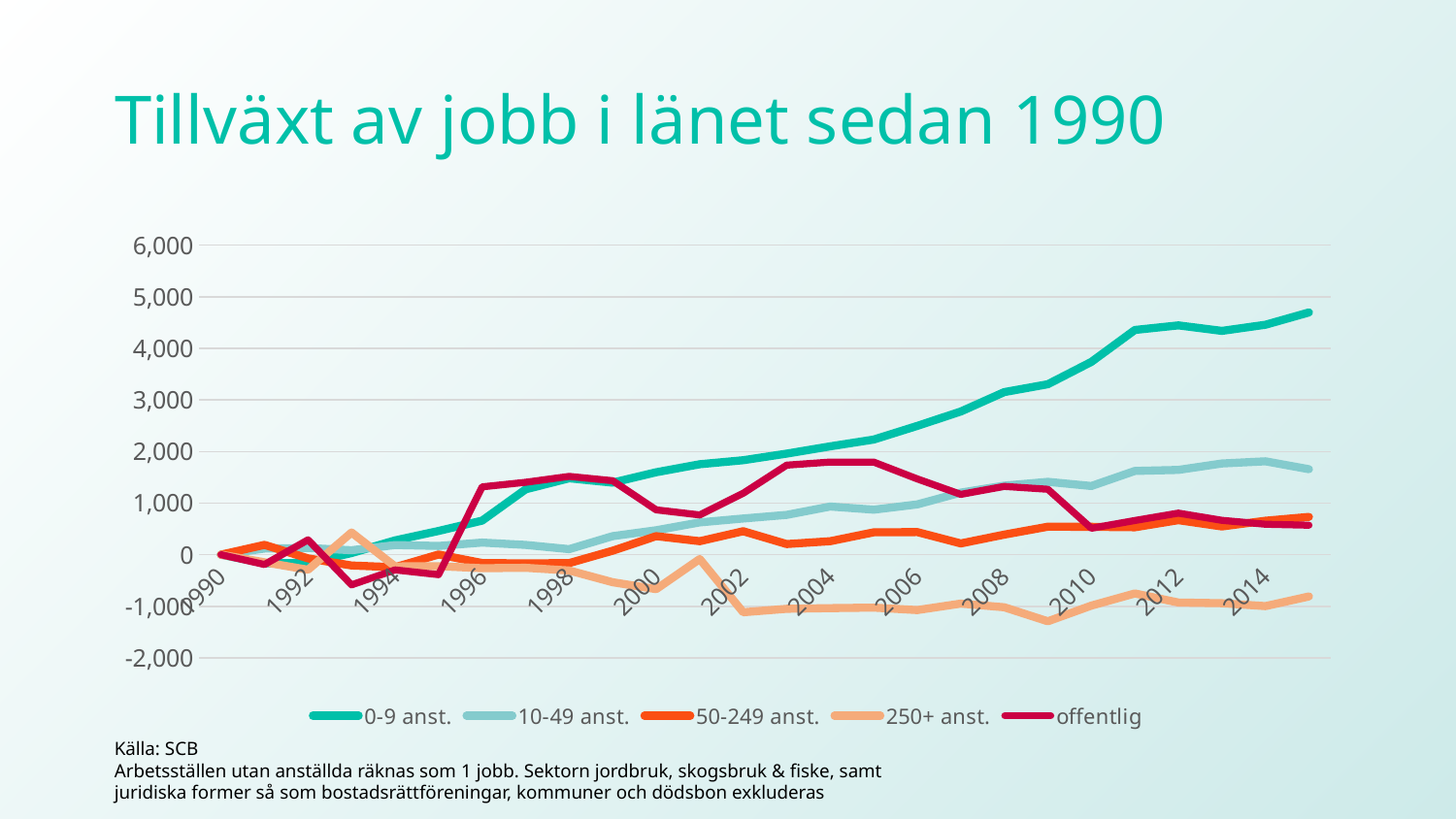
What kind of chart is shown on the slide? line chart How many series does the legend list? 5 Which series has the lowest value at the right end of the chart (2014)? 250+ anst. What is the title of the chart? Tillväxt av jobb i länet sedan 1990 In 2014, which is larger: the value for 10-49 anst. or the value for offentlig? 10-49 anst. Which series has the highest value at the right end of the chart (2014)? 0-9 anst. Is the value for offentlig in 2004 greater or less than 1,000? greater Is the value for 0-9 anst. in 2014 greater or less than 4,000? greater Does the 0-9 anst. series generally rise or fall from 1990 to 2014? rise Is the value for 10-49 anst. in 2012 greater or less than 1,000? greater What source is cited below the chart? SCB